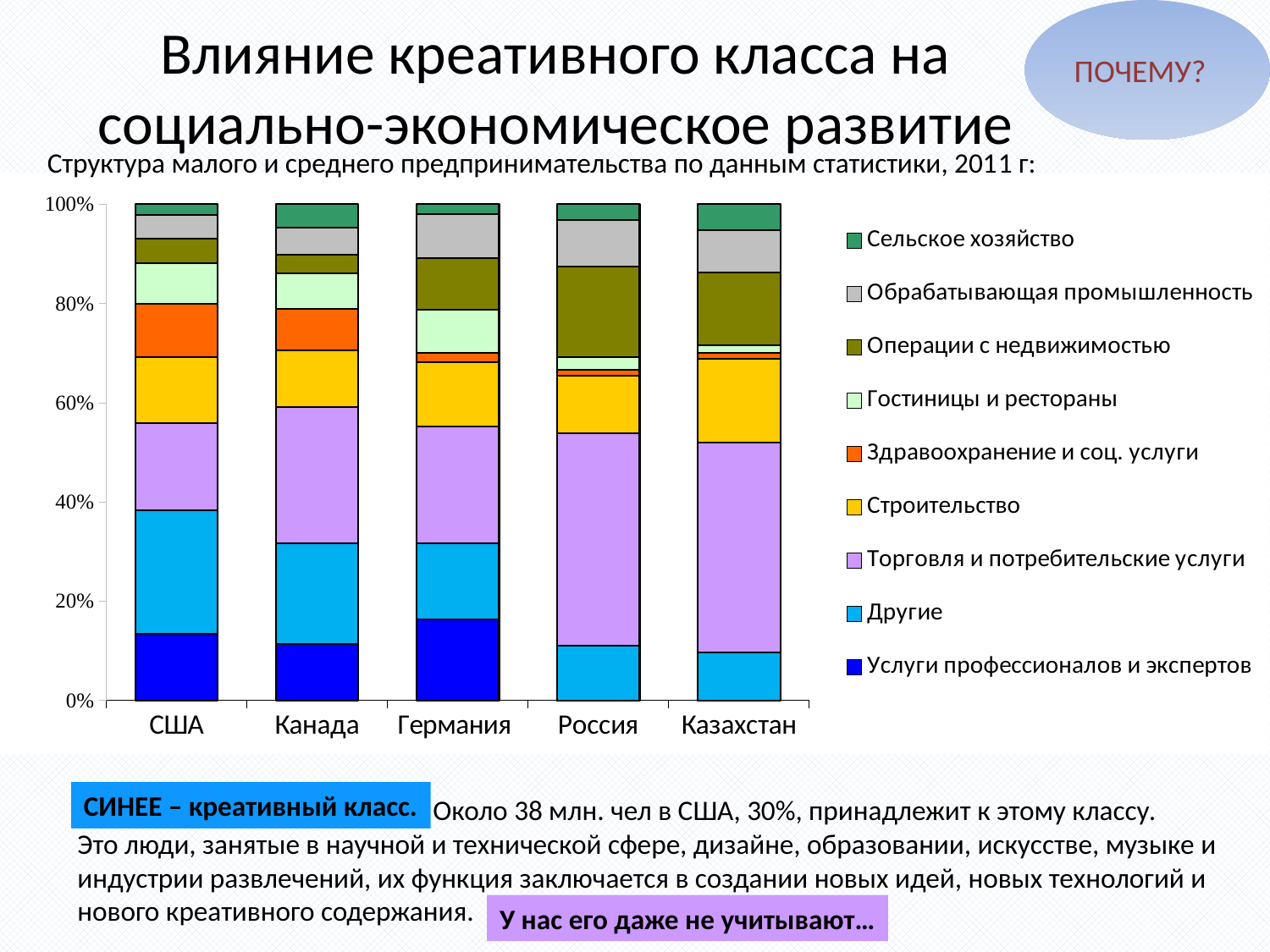
Which countries have no segment for Услуги профессионалов и экспертов? Россия and Казахстан Which is larger, the Торговля и потребительские услуги segment for Россия or for США? Россия How many series does the chart legend list? 9 Is the Другие segment for США greater or less than 20%? greater Which country has the largest Услуги профессионалов и экспертов segment? Германия What is the subtitle printed above the chart? Структура малого и среднего предпринимательства по данным статистики, 2011 г: Which is larger, the Здравоохранение и соц. услуги segment for США or for Германия? США What kind of chart is shown on the slide? Stacked bar chart Which country has the largest Другие segment? США Is the Торговля и потребительские услуги segment for Россия greater or less than 40%? greater Is the Услуги профессионалов и экспертов segment for Германия greater or less than 20%? less How many countries are shown on the x axis of the chart? 5